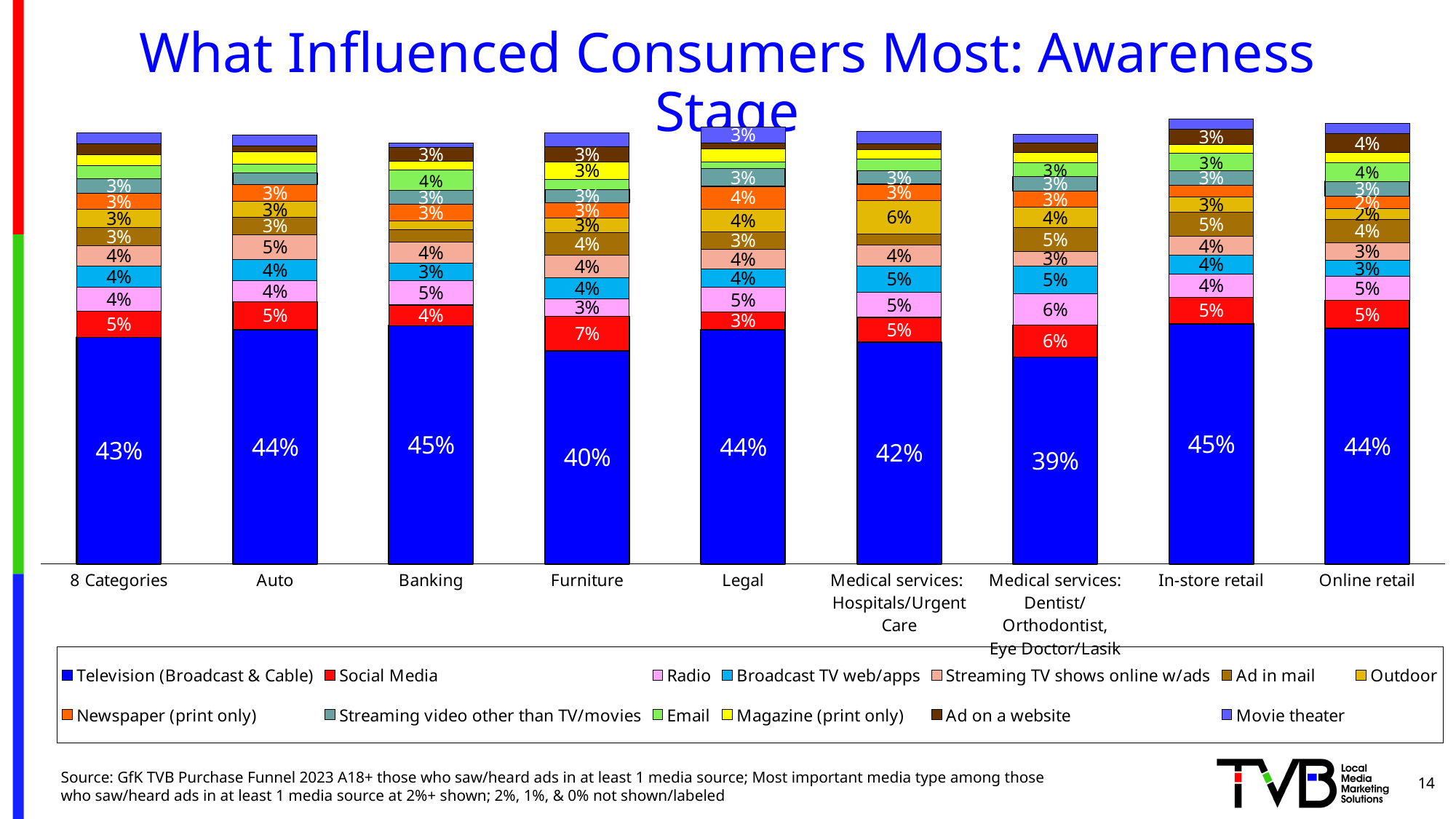
Which category has the highest Social Media value? Furniture How many categories are shown along the x axis? 9 How many series does the legend list? 13 What is the Social Media value for the Furniture category? 7% What is the difference between the Television (Broadcast & Cable) values for Banking and Medical services: Dentist/Orthodontist, Eye Doctor/Lasik? 6 percentage points Which category has the lowest Television (Broadcast & Cable) value? Medical services: Dentist/Orthodontist, Eye Doctor/Lasik What kind of chart is shown on the slide? Stacked bar chart What is the Outdoor value for Medical services: Hospitals/Urgent Care? 6% Which has a larger Television (Broadcast & Cable) value, Auto or Furniture? Auto What is the title of the chart? What Influenced Consumers Most: Awareness Stage What is the Radio value for Medical services: Dentist/Orthodontist, Eye Doctor/Lasik? 6% What is the value for Television (Broadcast & Cable) in the Furniture category? 40%